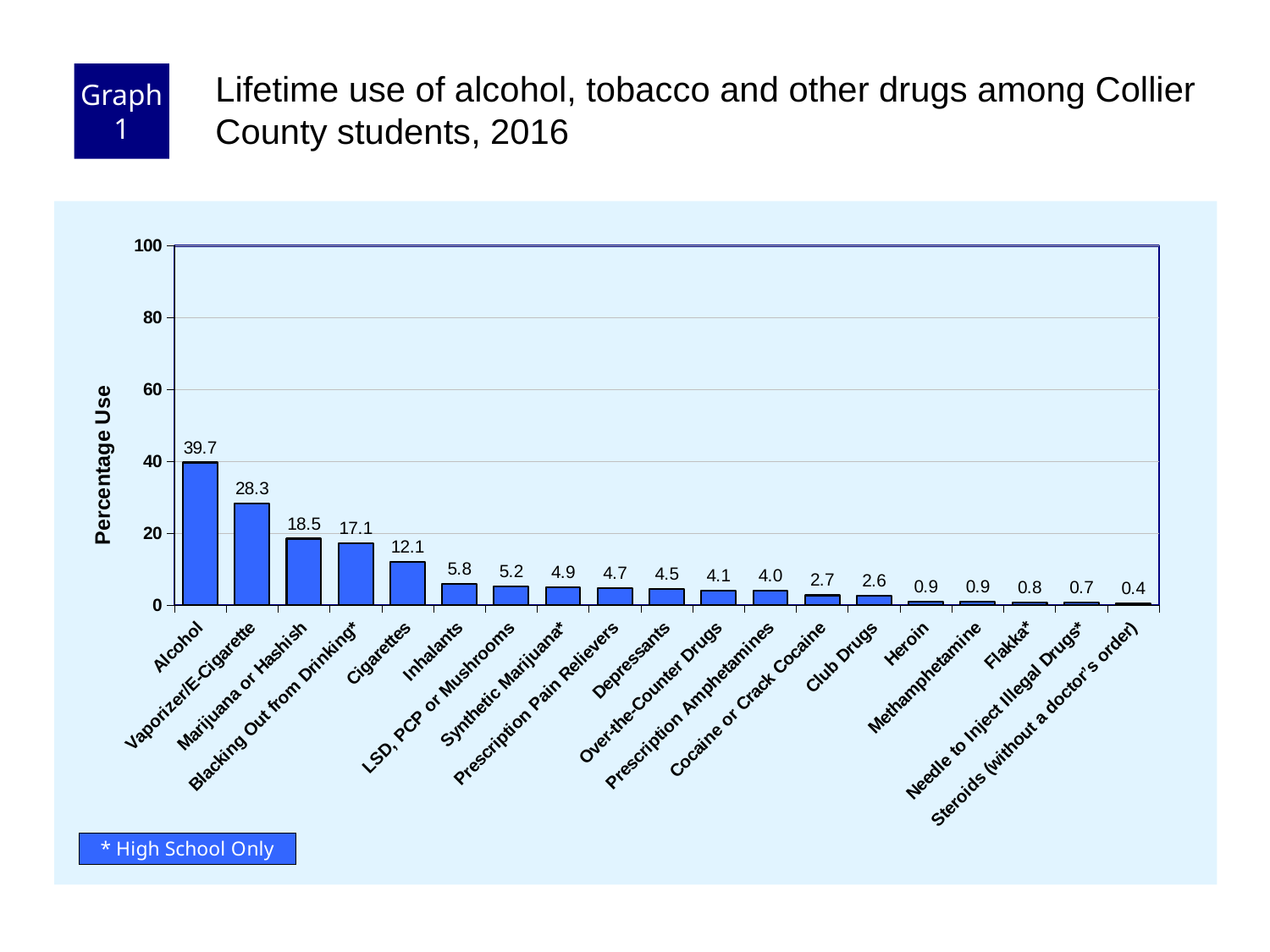
Which has a higher percentage use, Inhalants or Depressants? Inhalants What is the percentage use for Alcohol? 39.7 What is the difference in percentage use between Alcohol and Vaporizer/E-Cigarette? 11.4 Is the value for Vaporizer/E-Cigarette greater or less than 20? greater What is the percentage use for Cigarettes? 12.1 What is the percentage use for Club Drugs? 2.6 What is the label of the y axis? Percentage Use What is the difference in percentage use between Marijuana or Hashish and Cigarettes? 6.4 How many categories are shown on the x axis? 19 Which category has the highest percentage use? Alcohol Which category has the lowest percentage use? Steroids (without a doctor's order) What kind of chart is shown on the slide? Bar chart